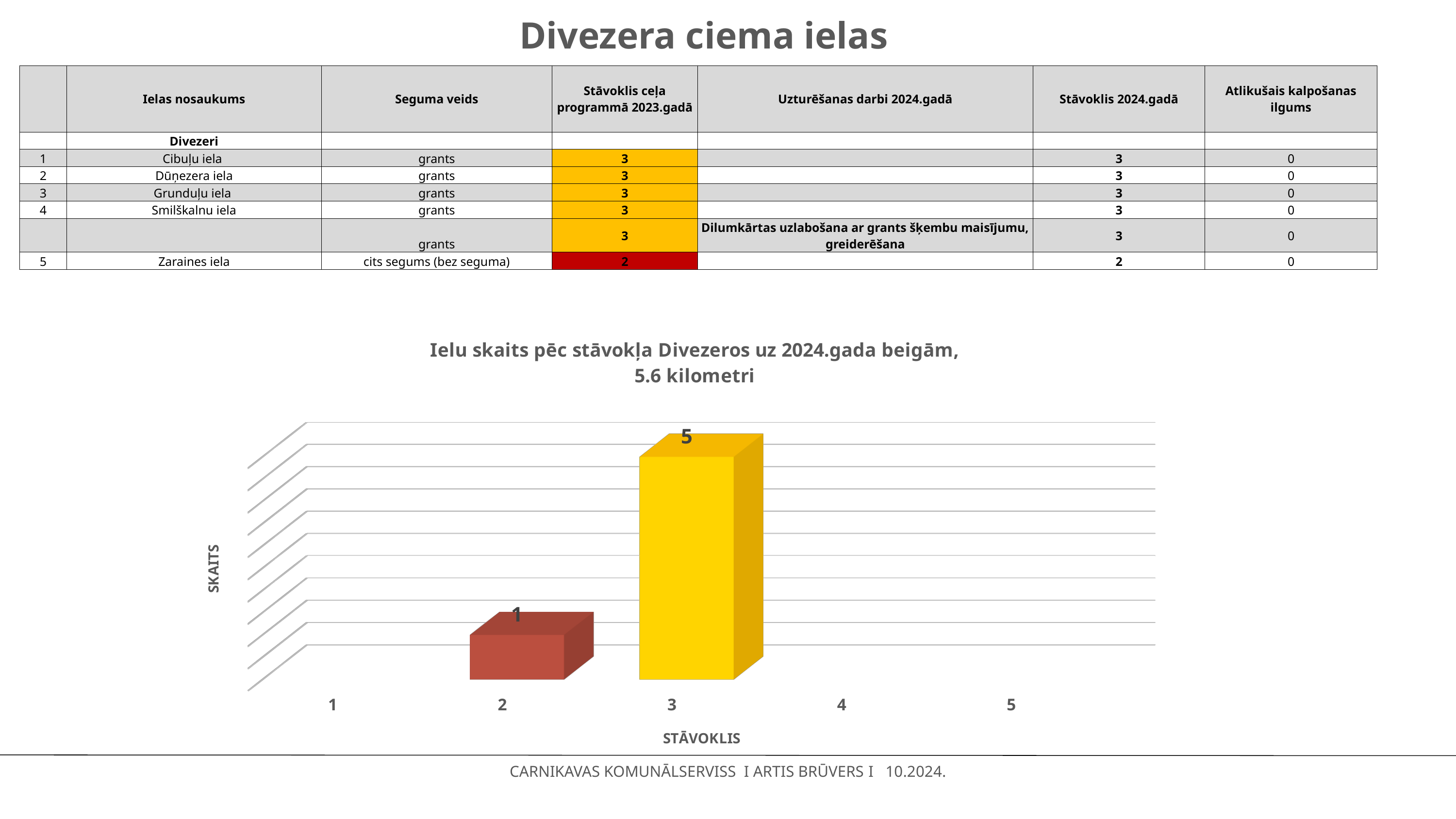
Which is larger, the value for condition category 2 or condition category 3? 3 What is the label of the x axis of the chart? STĀVOKLIS What kind of chart is shown on the slide? Bar chart How many condition categories are shown on the x axis of the chart? 5 How many condition categories in the chart have a visible bar? 2 What is the value for condition category 3 in the chart? 5 What is the value for condition category 2 in the chart? 1 What is the title of the chart? Ielu skaits pēc stāvokļa Divezeros uz 2024.gada beigām, 5.6 kilometri Which condition category has the highest number of streets in the chart? 3 What is the difference between the values for condition categories 3 and 2? 4